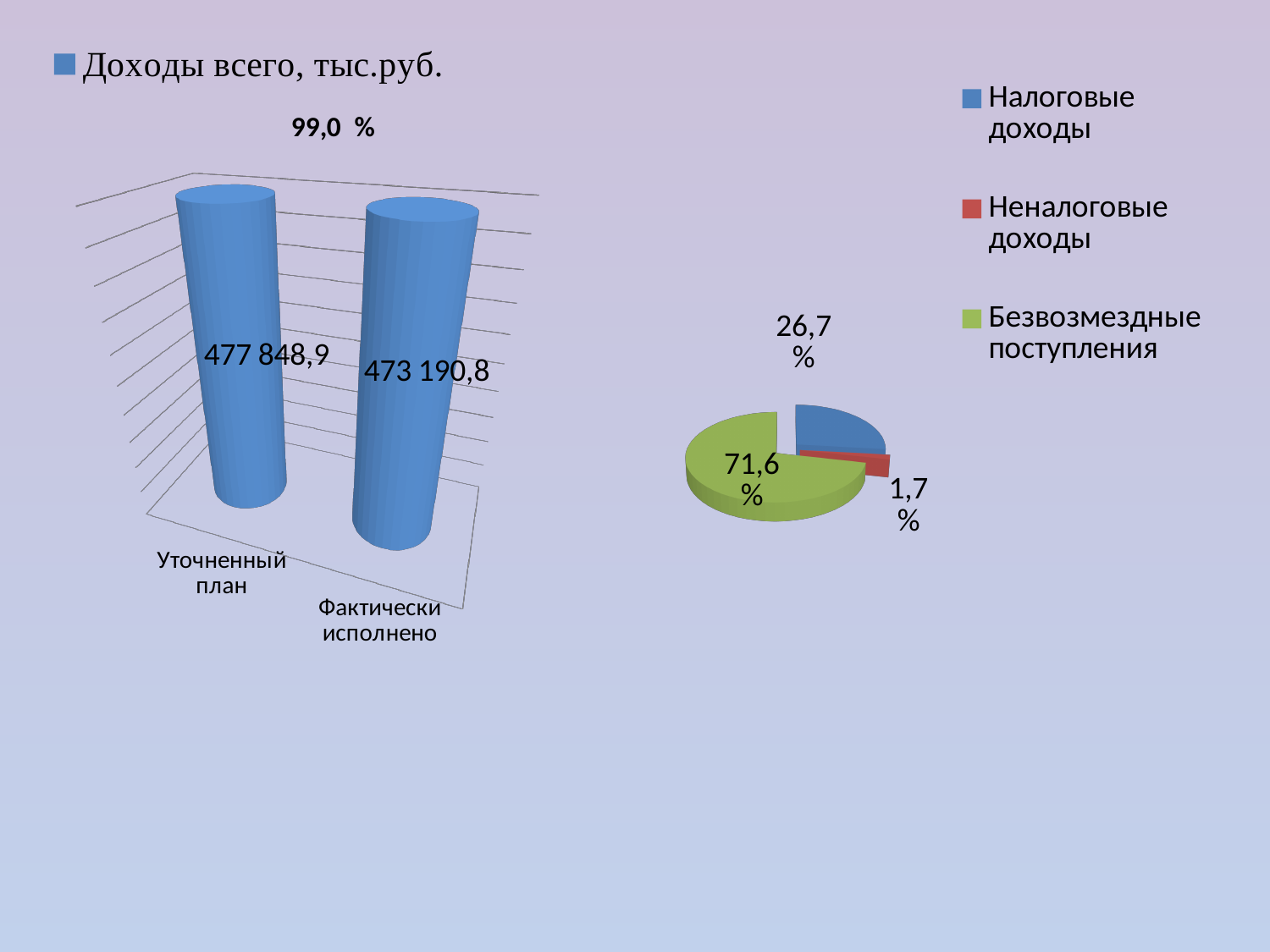
In the left chart (Доходы всего, тыс.руб.), what is the value for Фактически исполнено? 473 190,8 What kind of chart is the left chart (Доходы всего, тыс.руб.)? Bar chart In the pie chart on the right, what share do Налоговые доходы have? 26,7% In the pie chart on the right, which slice is the largest? Безвозмездные поступления In the left chart (Доходы всего, тыс.руб.), how many categories are plotted? 2 In the left chart (Доходы всего, тыс.руб.), what is the value for Уточненный план? 477 848,9 In the left chart, what percentage is printed above the bars? 99,0 % In the pie chart on the right, what share do Неналоговые доходы have? 1,7% In the left chart (Доходы всего, тыс.руб.), which category has the higher value? Уточненный план In the pie chart on the right, how many entries does the legend list? 3 In the left chart (Доходы всего, тыс.руб.), what is the difference between Уточненный план and Фактически исполнено? 4 658,1 In the pie chart on the right, what share do Безвозмездные поступления have? 71,6%